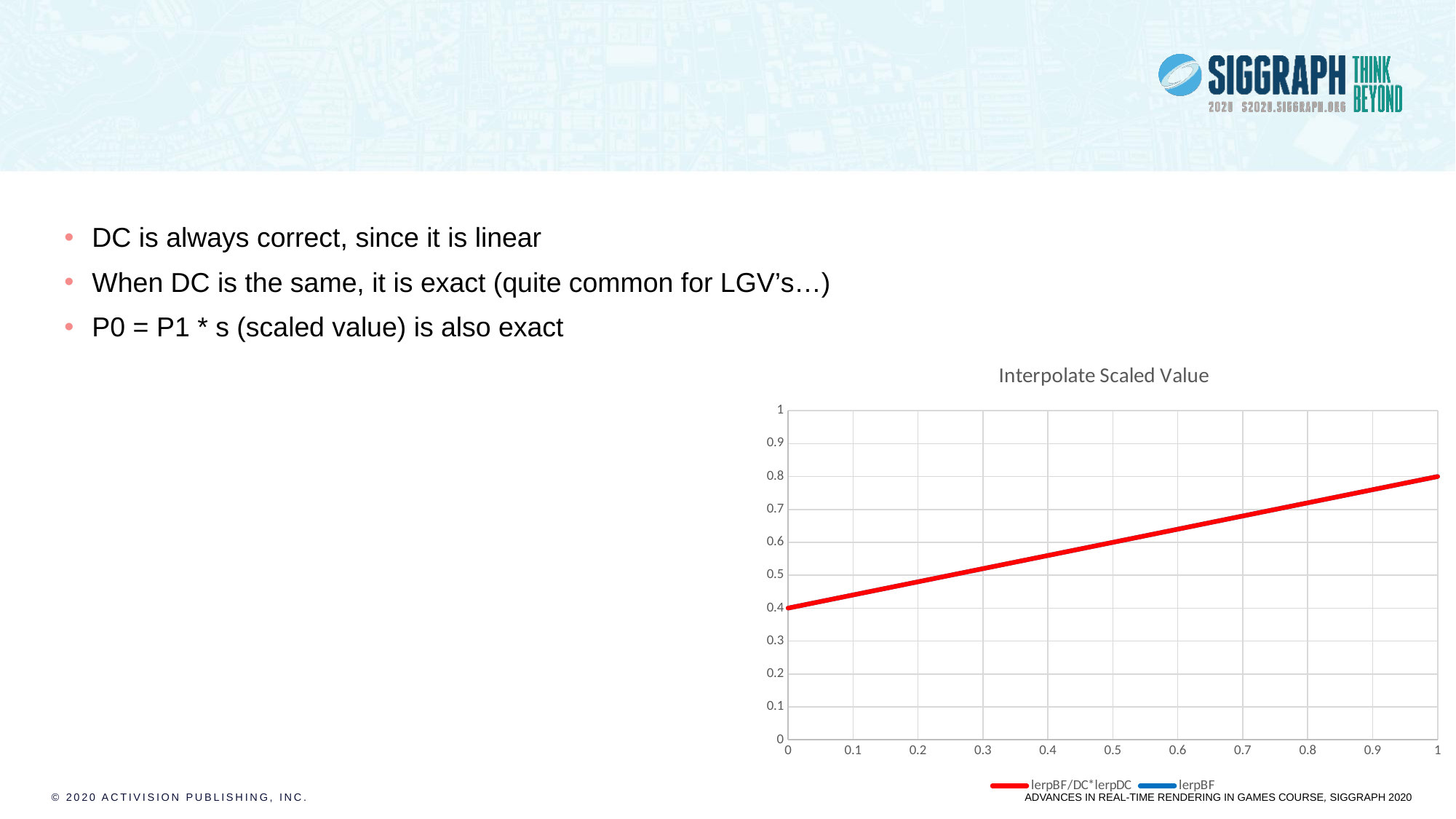
Does the red line rise or fall as x increases from 0 to 1? rise What is the title of the chart? Interpolate Scaled Value What is the maximum value shown on the y axis? 1 Which is larger, the red line's value at x = 0 or at x = 1? x = 1 What is the value of the red line at x = 0? 0.4 Which series is drawn in red according to the legend? lerpBF/DC*lerpDC What is the value of the red line at x = 1? 0.8 What kind of chart is shown on the slide? line chart How many series does the chart's legend list? 2 Is the value of the red line at x = 0.2 greater or less than 0.5? less What is the difference between the red line's value at x = 1 and at x = 0? 0.4 Is the value of the red line at x = 0.8 greater or less than 0.7? greater